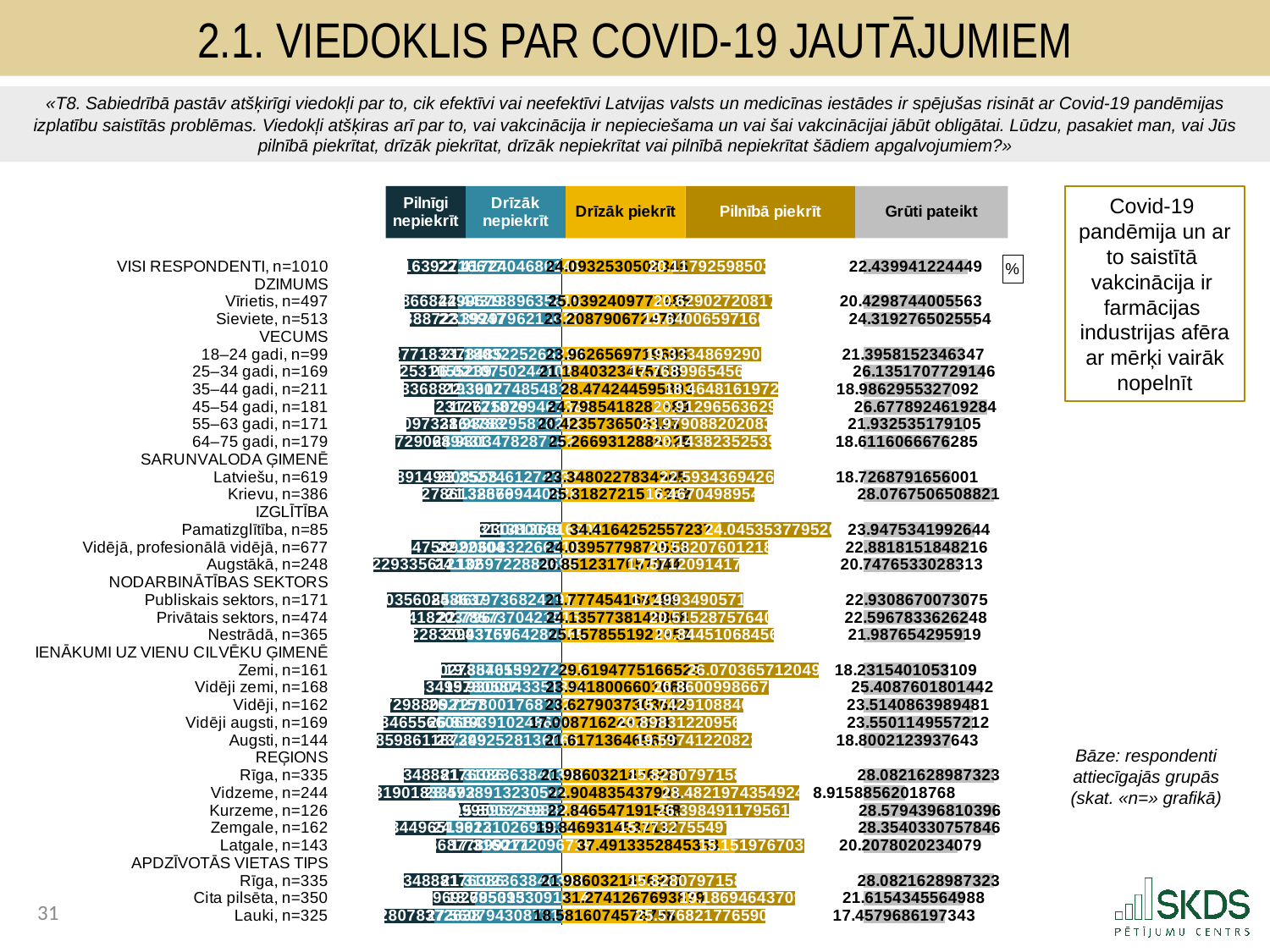
What is the 'Grūti pateikt' value for VISI RESPONDENTI, n=1010? 22.439941224449 Which has the larger 'Grūti pateikt' value, Latviešu, n=619 or Krievu, n=386? Krievu, n=386 How many series does the chart legend list? 5 How many respondent groups (bars) are plotted in the chart? 30 What is the first (leftmost) series listed in the chart legend? Pilnīgi nepiekrīt What is the 'Grūti pateikt' value for Vidzeme, n=244? 8.91588562018768 Which respondent group has the lowest 'Grūti pateikt' value? Vidzeme, n=244 What is the 'Grūti pateikt' value for 64–75 gadi, n=179? 18.6116066676285 Which has the larger 'Grūti pateikt' value, Rīga, n=335 or Vidzeme, n=244? Rīga, n=335 What kind of chart is shown on the slide? Stacked bar chart Which series is shown in grey in the chart legend? Grūti pateikt Which has the larger 'Grūti pateikt' value, Vīrietis, n=497 or Sieviete, n=513? Sieviete, n=513